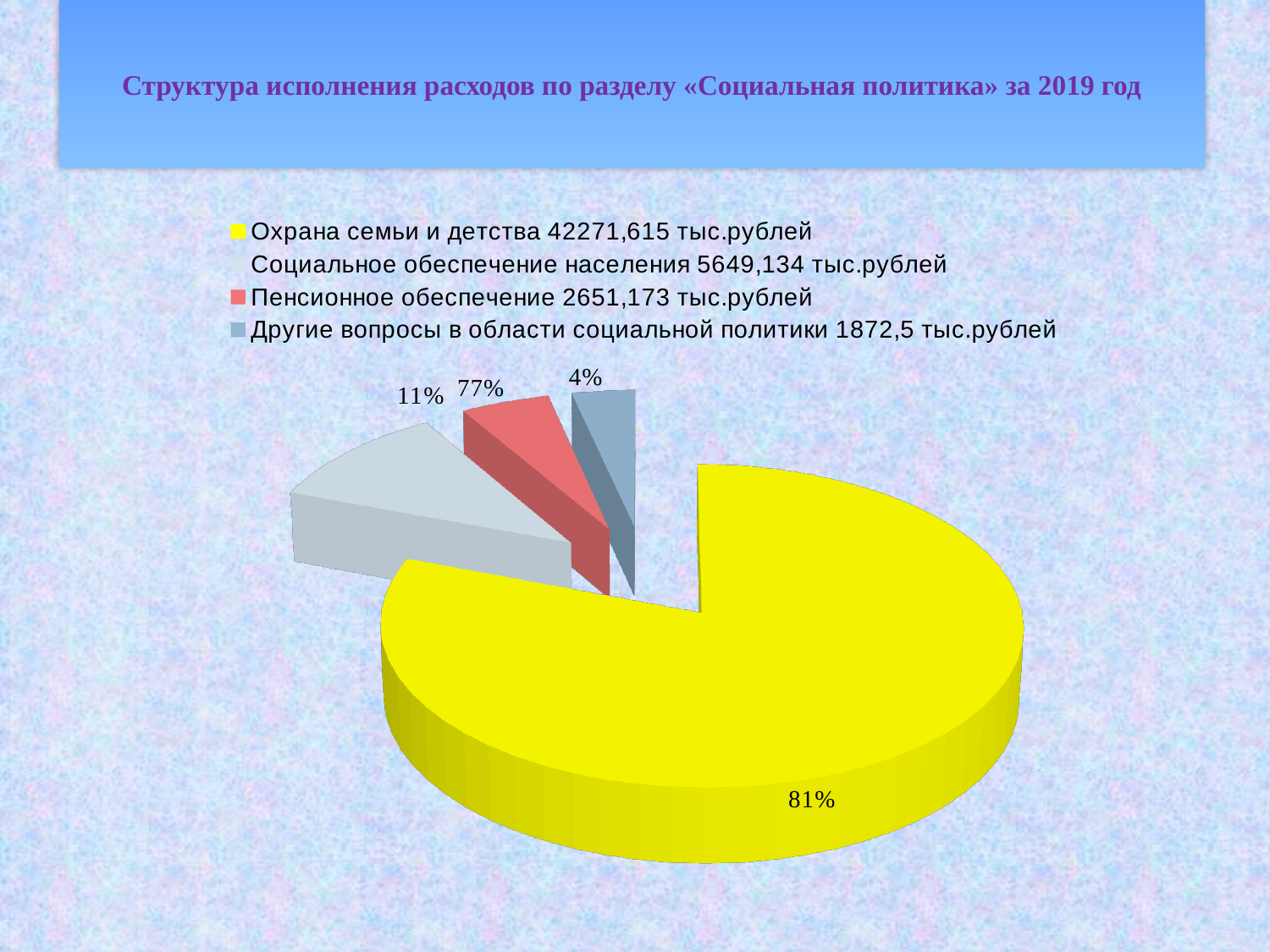
What is the difference between the legend values for Социальное обеспечение населения and Пенсионное обеспечение? 2997,961 тыс.рублей How many slices does the pie chart have? 4 What value does the legend give for Другие вопросы в области социальной политики? 1872,5 тыс.рублей What colour is the largest slice of the pie? Yellow What kind of chart is shown on the slide? Pie chart Which category has the largest share of the pie? Охрана семьи и детства What value does the legend give for Социальное обеспечение населения? 5649,134 тыс.рублей What share of the pie is labelled for Охрана семьи и детства? 81% Which is larger according to the legend: Социальное обеспечение населения or Пенсионное обеспечение? Социальное обеспечение населения What value does the legend give for Пенсионное обеспечение? 2651,173 тыс.рублей Which category has the smallest share of the pie? Другие вопросы в области социальной политики What value does the legend give for Охрана семьи и детства? 42271,615 тыс.рублей